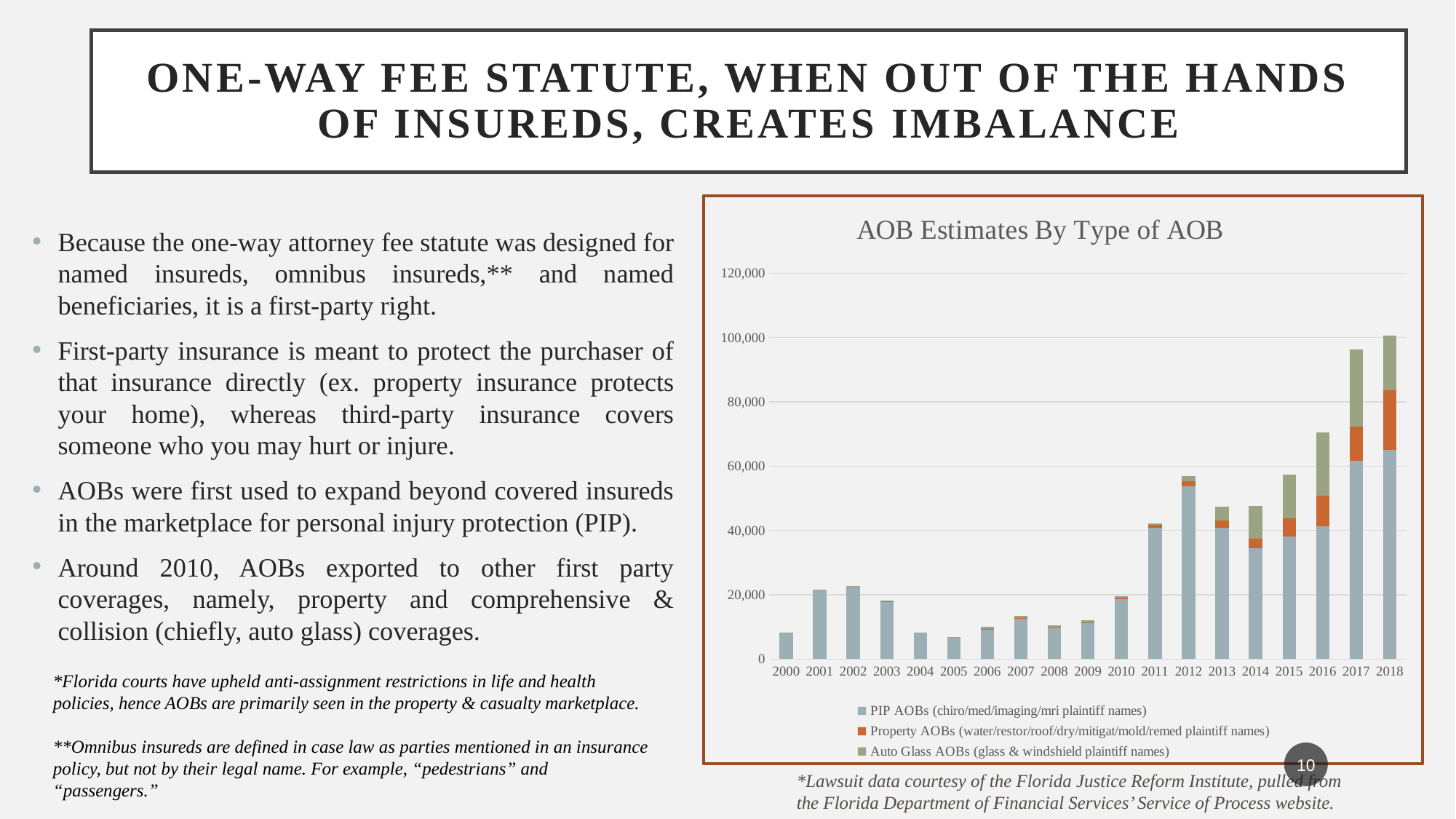
How many series does the chart's legend list? 3 Is the total AOB estimate for 2005 greater or less than 20,000? less Which year has the larger total AOB estimate, 2012 or 2017? 2017 What is the title of the chart? AOB Estimates By Type of AOB Which series is shown in green in the chart? Auto Glass AOBs (glass & windshield plaintiff names) What kind of chart is shown on the slide? Stacked bar chart Is the total AOB estimate for 2014 greater or less than 40,000? greater Do the total AOB estimates generally rise or fall from 2014 to 2018? Rise Is the total AOB estimate for 2016 greater or less than 60,000? greater How many years are shown along the x axis of the chart? 19 Which year has the highest total AOB estimate? 2018 Which year has the larger total AOB estimate, 2002 or 2003? 2002